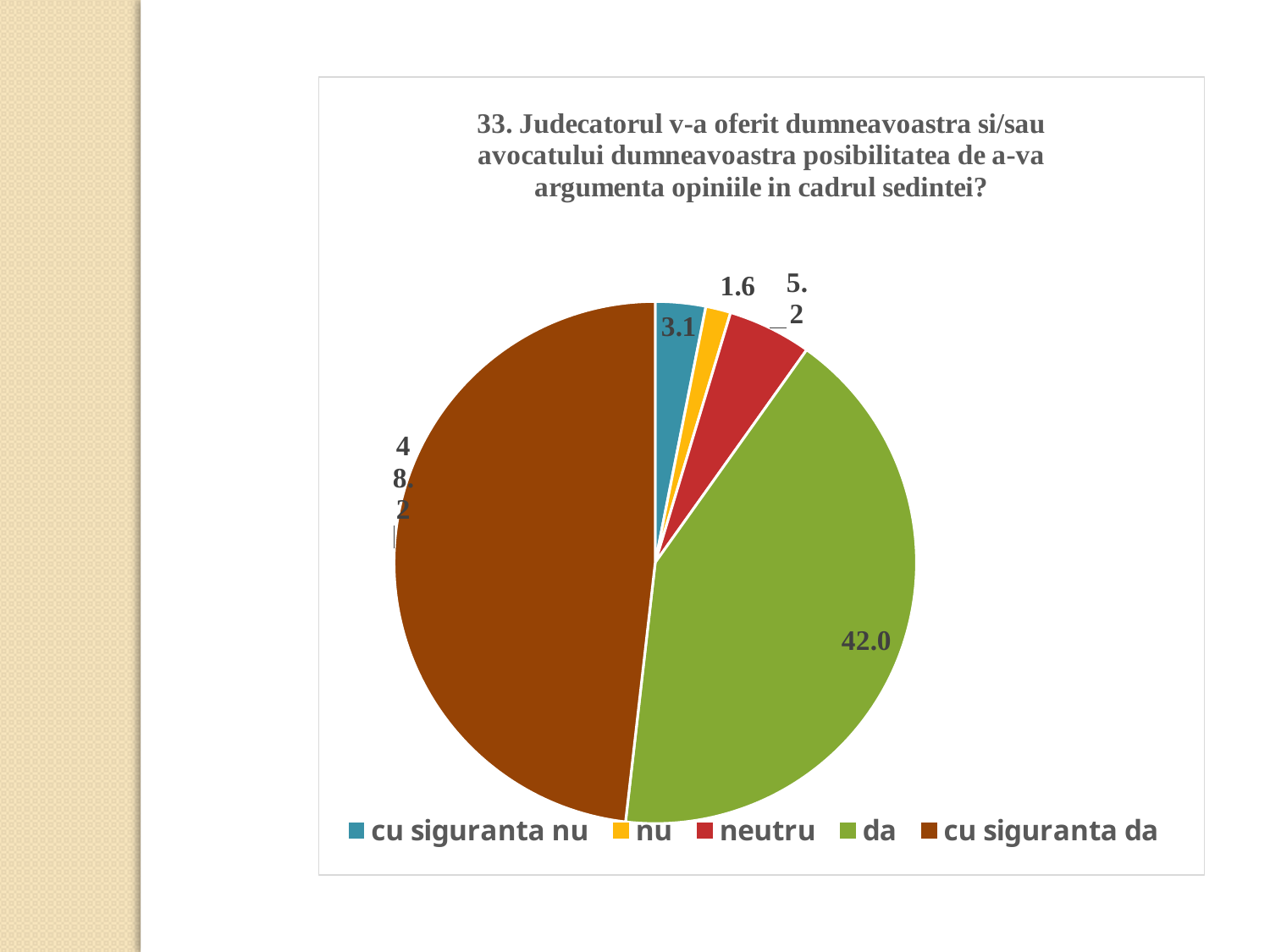
What kind of chart is shown on the slide? pie chart What is the value for "neutru"? 5.2 What is the value for "nu"? 1.6 What is the difference between the values for "cu siguranta da" and "da"? 6.2 What is the value for "da"? 42.0 What colour is the slice for "da"? green Which is larger, the value for "neutru" or the value for "cu siguranta nu"? neutru Which category has the largest slice of the pie? cu siguranta da How many categories does the pie chart show? 5 Which category has the smallest slice of the pie? nu What is the value for "cu siguranta nu"? 3.1 What is the value for "cu siguranta da"? 48.2